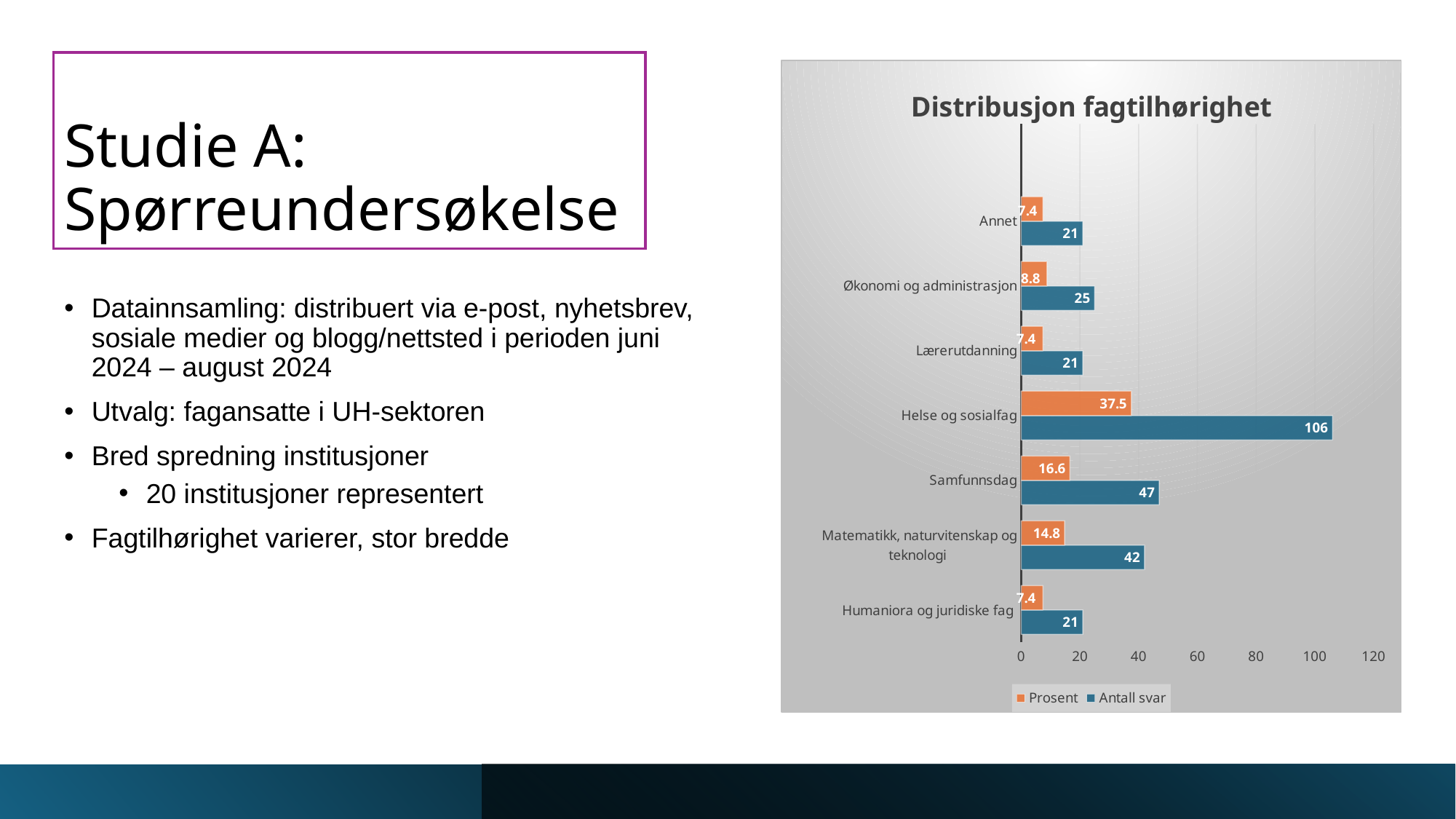
What kind of chart is shown on the slide? Bar chart What is the difference in 'Antall svar' between Helse og sosialfag and Samfunnsdag? 59 Which category has the highest 'Antall svar' value? Helse og sosialfag Which category has the highest 'Prosent' value? Helse og sosialfag What is the 'Prosent' value for Samfunnsdag? 16.6 What is the 'Antall svar' value for Økonomi og administrasjon? 25 What is the title of the chart? Distribusjon fagtilhørighet How many categories are shown on the chart? 7 What is the 'Prosent' value for Matematikk, naturvitenskap og teknologi? 14.8 Which has a larger 'Antall svar' value, Samfunnsdag or Matematikk, naturvitenskap og teknologi? Samfunnsdag How many series does the legend list? 2 What is the 'Antall svar' value for Helse og sosialfag? 106